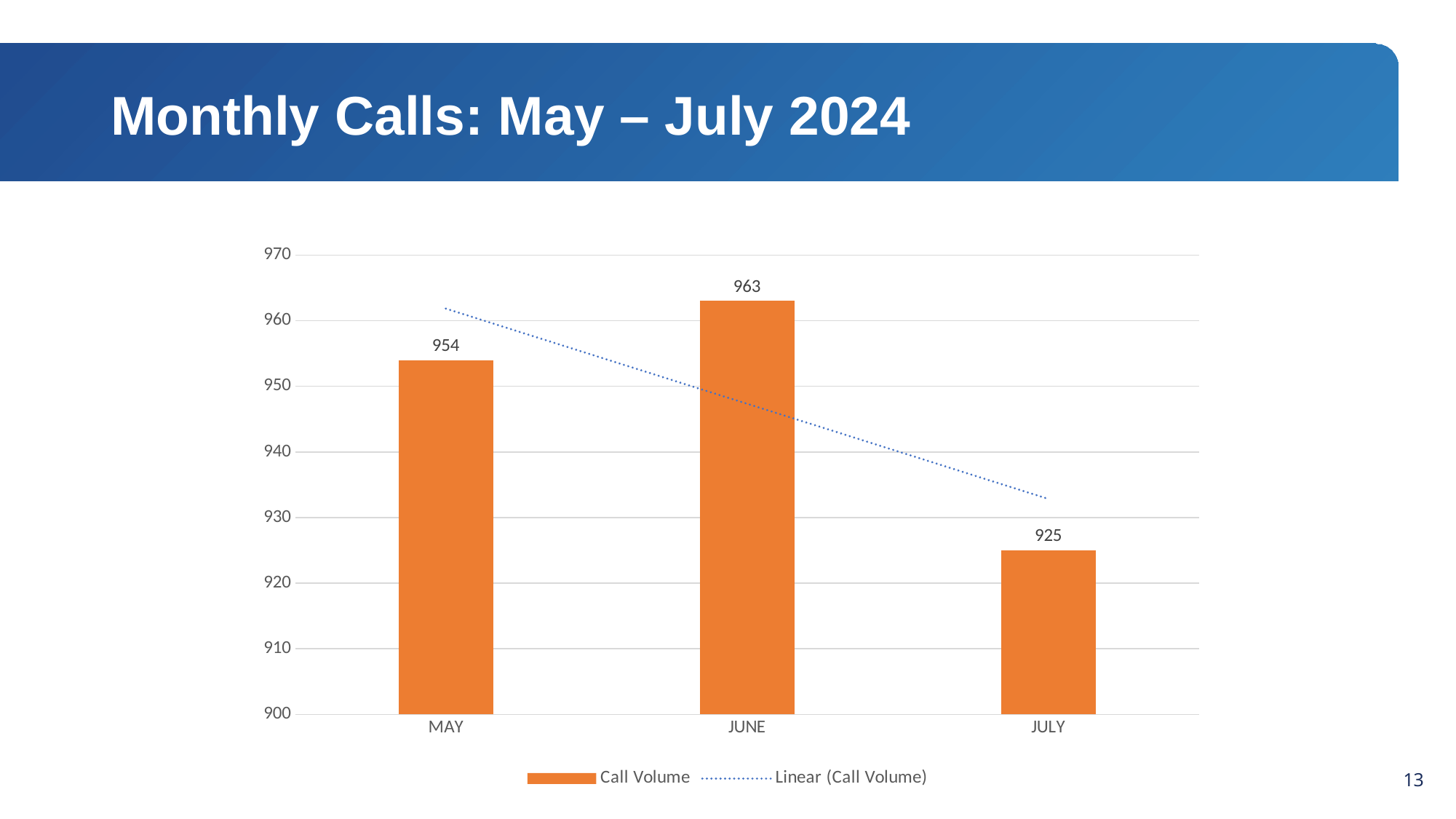
Which month has a larger call volume, May or July? May Which month has the highest call volume? June What does the dotted line in the chart represent, according to the legend? Linear (Call Volume) What is the call volume for June? 963 What is the difference in call volume between June and May? 9 What is the call volume for May? 954 How many months are shown on the chart? 3 What is the call volume for July? 925 What is the difference in call volume between June and July? 38 Which month has the lowest call volume? July What kind of chart is shown on the slide? Bar chart Is the call volume for July greater or less than 930? less